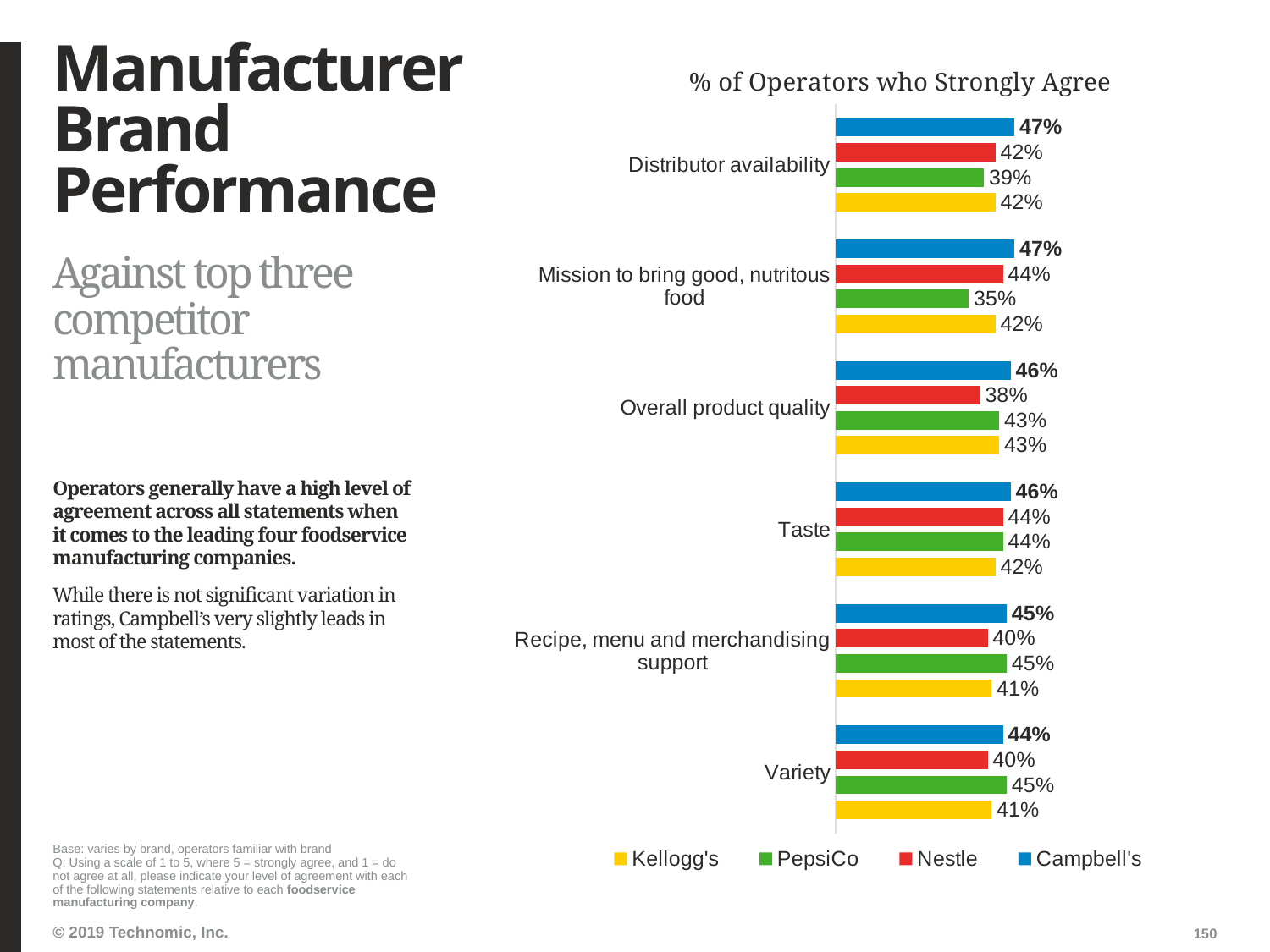
How many series does the legend list? 4 What is the value for PepsiCo on Mission to bring good, nutritous food? 35% Which manufacturer has the highest value for Overall product quality? Campbell's Which is larger on Variety, PepsiCo or Campbell's? PepsiCo What type of chart is shown on the slide? Bar chart Which manufacturer has the lowest value for Mission to bring good, nutritous food? PepsiCo What is the value for Campbell's on Distributor availability? 47% How many statement categories are shown on the chart? 6 What is the value for Kellogg's on Variety? 41% What is the value for Nestle on Overall product quality? 38% What is the title of the chart? % of Operators who Strongly Agree What is the difference between Campbell's and Nestle on Overall product quality? 8%